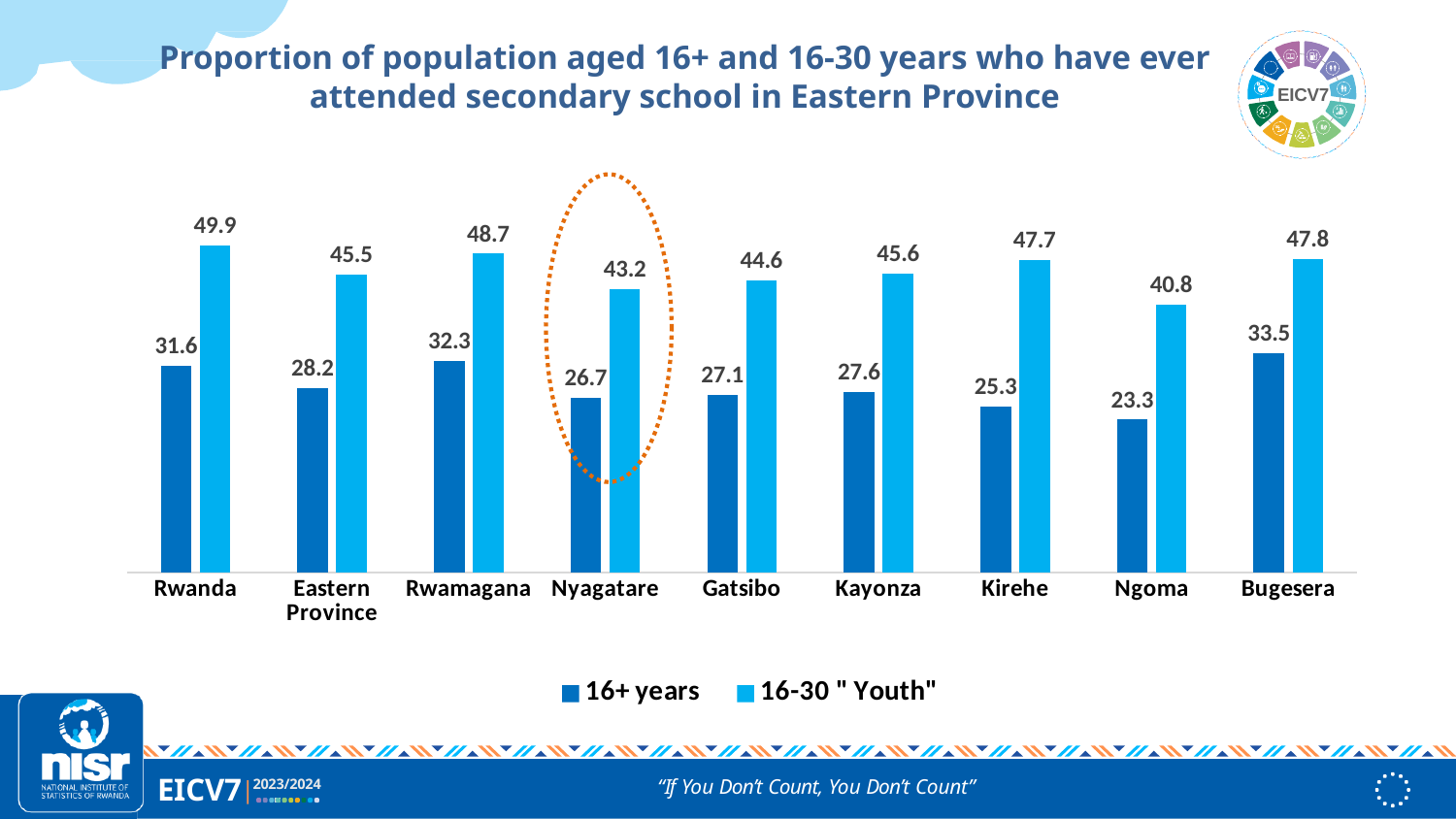
Which is larger for the 16+ years series: Gatsibo or Kayonza? Kayonza What is the value for the 16+ years series in Rwamagana? 32.3 What kind of chart is shown on the slide? Bar chart What is the value for the 16-30 "Youth" series in Nyagatare? 43.2 Which category has the lowest value for the 16+ years series? Ngoma Which category has the highest value for the 16+ years series? Bugesera How many series does the legend list? 2 What is the difference between the 16-30 "Youth" value and the 16+ years value for Rwanda? 18.3 How many categories are shown on the x axis? 9 What is the difference between the 16-30 "Youth" value and the 16+ years value for Kirehe? 22.4 What is the value for the 16+ years series in Eastern Province? 28.2 Which category has the lowest value for the 16-30 "Youth" series? Ngoma